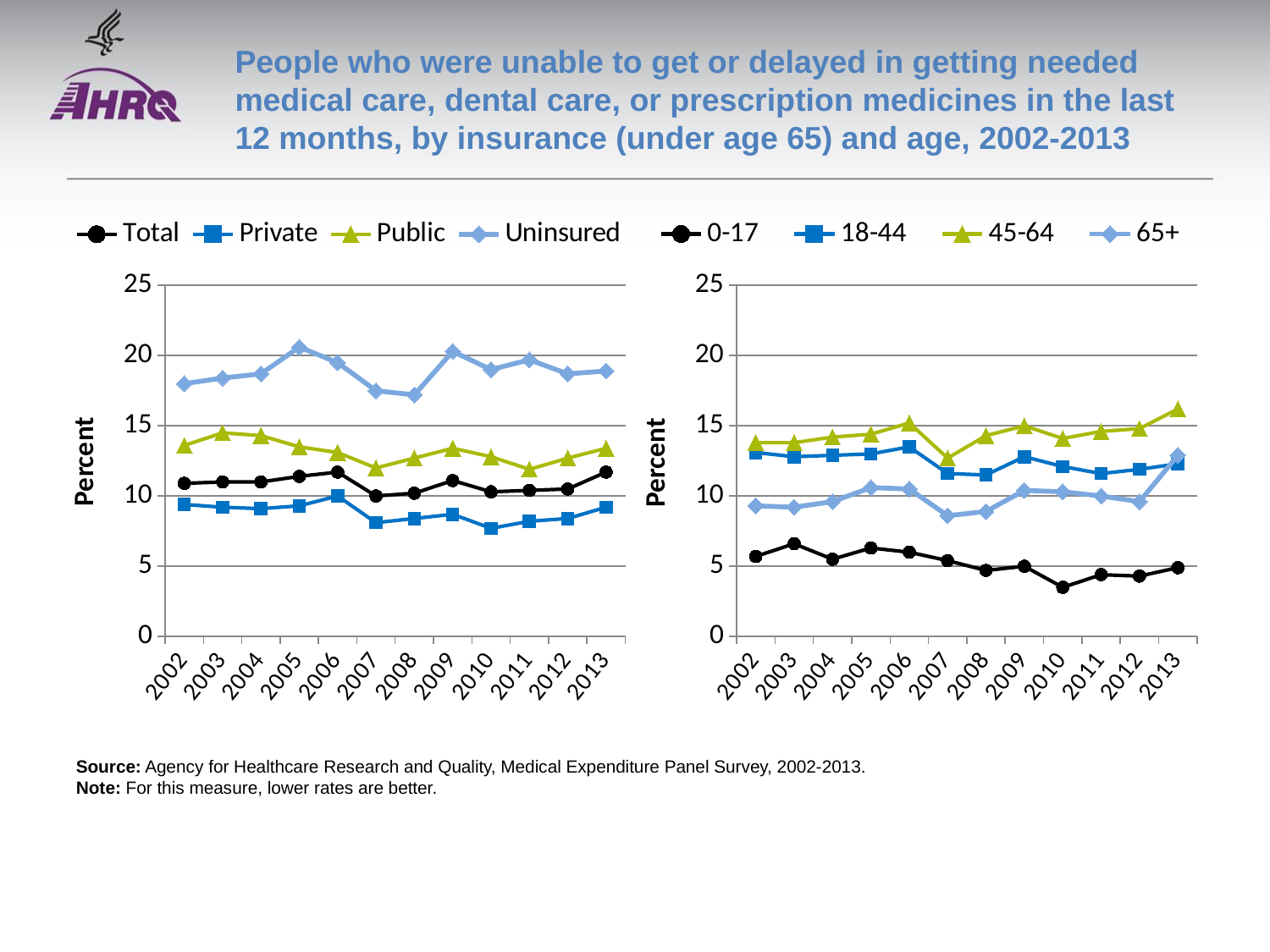
In the left chart (by insurance), which series has the lowest value in 2010? Private How many years are shown on the x axis of the right chart (by age)? 12 What kind of chart is the left chart (by insurance)? line chart In the left chart (by insurance), which series has the highest value in 2005? Uninsured In the right chart (by age), which age group has the lowest values across all years? 0-17 What is the label on the y axis of the left chart (by insurance)? Percent In the right chart (by age), which age group has the highest value in 2013? 45-64 How many series does the legend of the left chart (by insurance) list? 4 How many series does the legend of the right chart (by age) list? 4 In the left chart (by insurance), is the value for Uninsured in 2007 greater or less than 15? greater In the right chart (by age), is the value for 0-17 in 2010 greater or less than 5? less In the left chart (by insurance), which is larger in 2006, Total or Private? Total